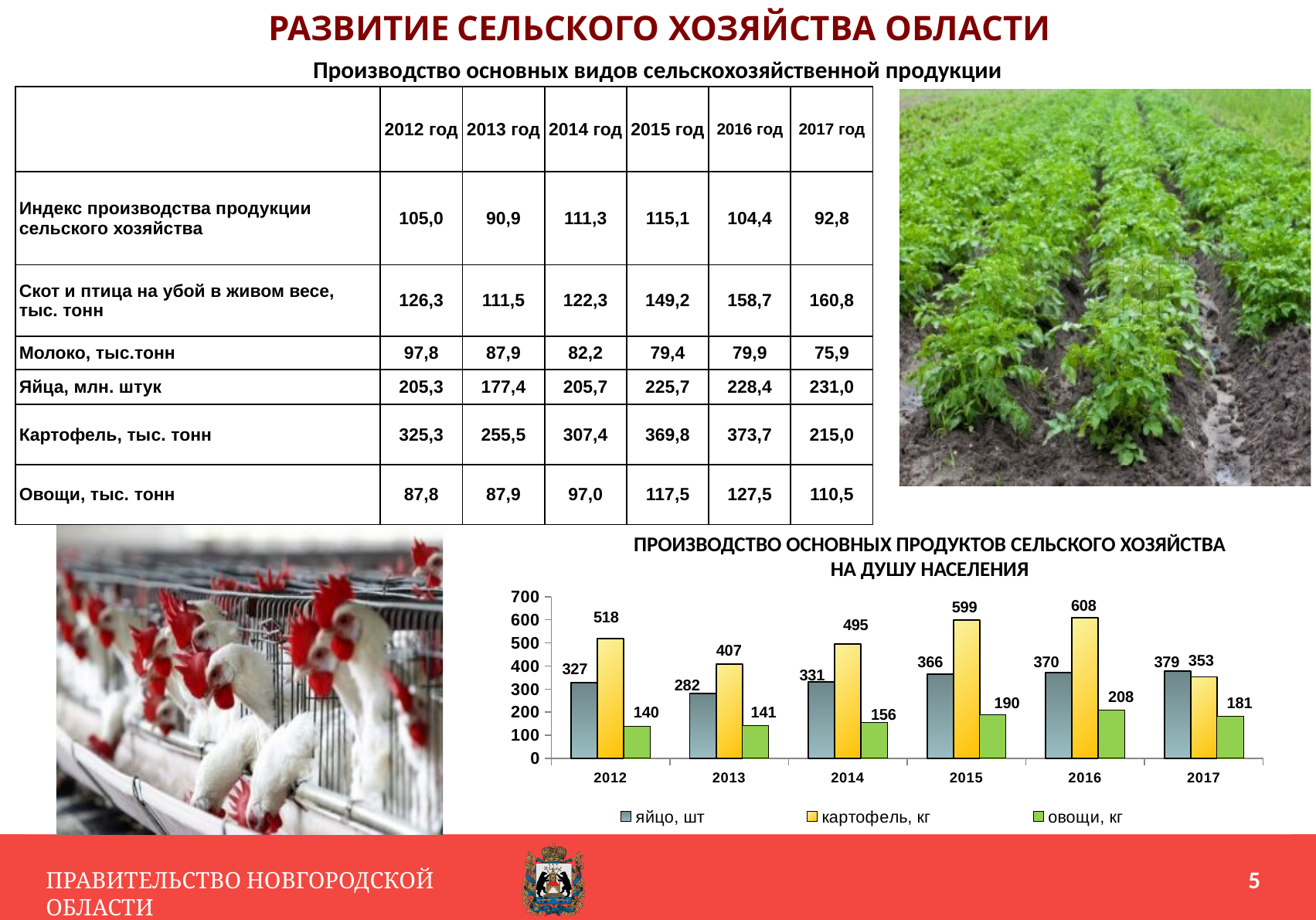
In which year is the value for картофель, кг the highest? 2016 What is the value for картофель, кг in 2016? 608 In which year is the value for овощи, кг the lowest? 2012 Which is larger in 2017: яйцо, шт or картофель, кг? яйцо, шт What is the value for яйцо, шт in 2013? 282 How many series does the chart legend list? 3 What kind of chart is shown on the slide? bar chart Is the value for овощи, кг in 2016 greater or less than 200? greater What is the value for овощи, кг in 2015? 190 What is the difference between the картофель, кг values for 2016 and 2017? 255 Does the value for яйцо, шт rise or fall from 2013 to 2017? rise How many years are shown on the x axis of the chart? 6